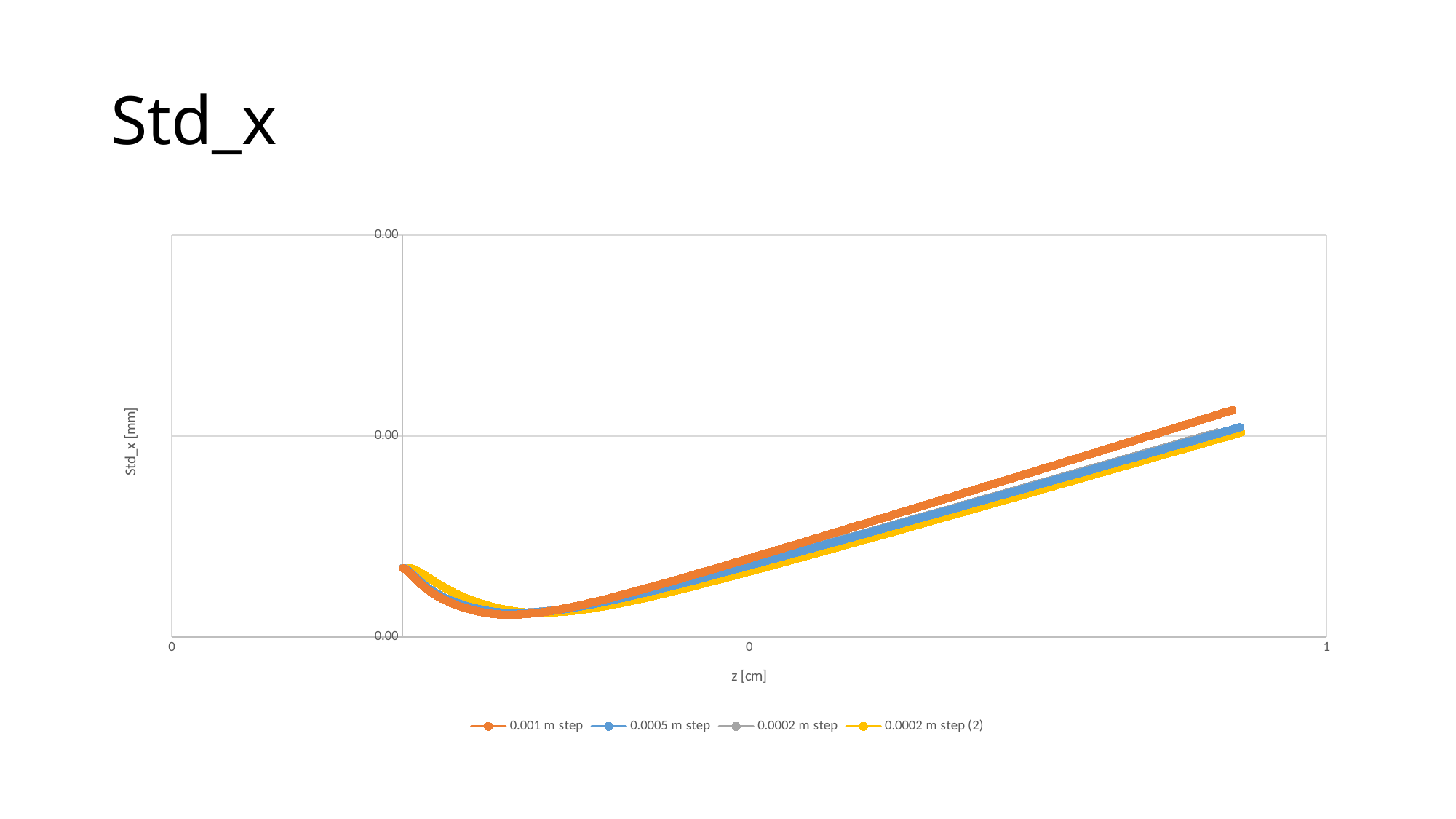
What is the label of the x axis? z [cm] At the right end of the chart, is the value for the 0.001 m step series larger or smaller than the value for the 0.0005 m step series? larger What is the title of the chart on the slide? Std_x How many series does the legend list? 4 From the middle of the x axis to the right end, do the plotted values rise or fall? rise Near the left end of the chart, do the plotted values initially rise or fall as z increases? fall Which series reaches the highest value at the right end of the chart? 0.001 m step What kind of chart is shown on the slide? line chart